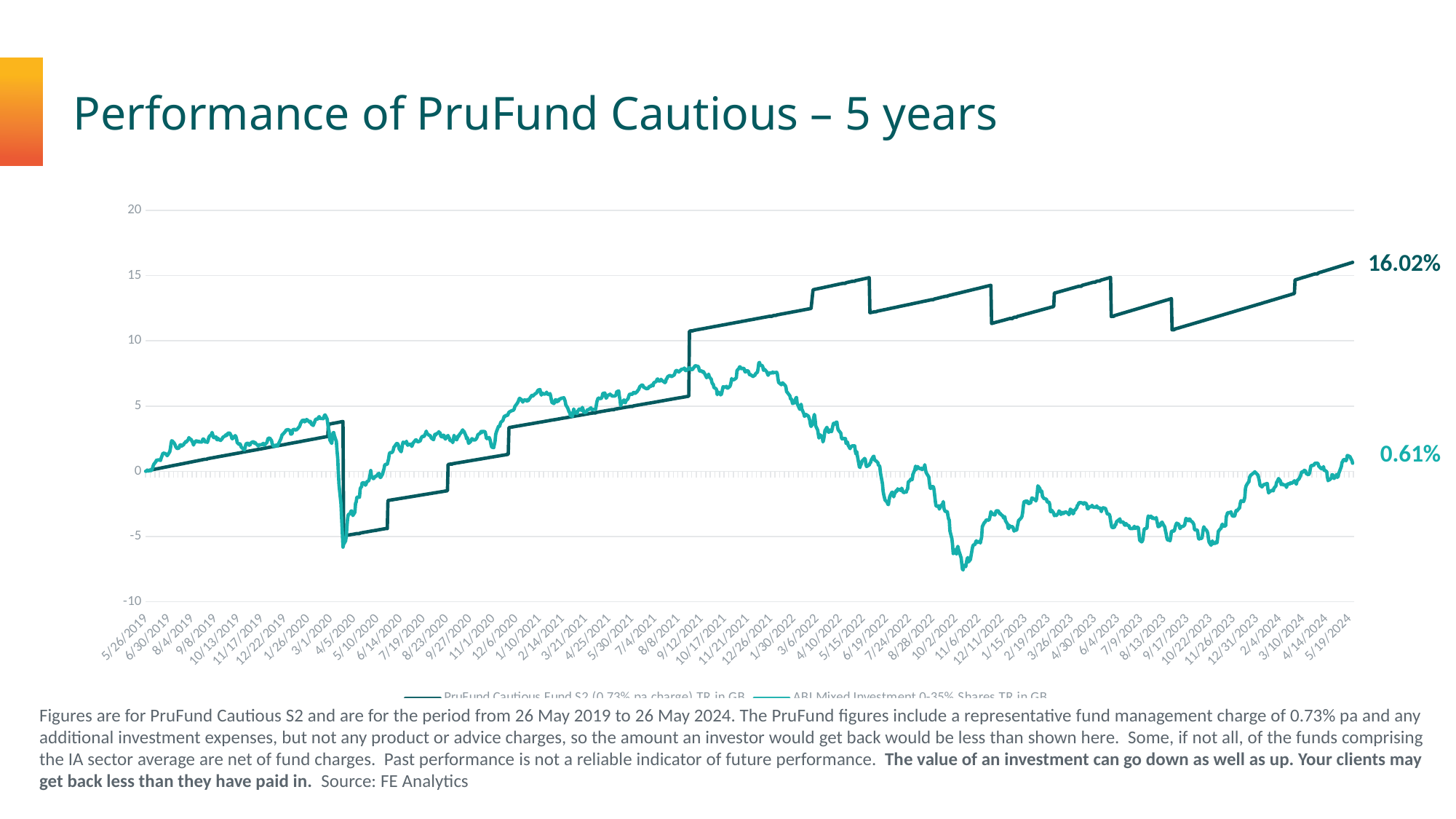
By how many percentage points does the PruFund Cautious Fund S2 end value exceed the ABI Mixed Investment 0-35% Shares end value? 15.41 How many series does the legend list? 2 What type of chart is shown on the slide? line chart What is the title of the chart slide? Performance of PruFund Cautious – 5 years Around 1/30/2022, is the value of the PruFund Cautious Fund S2 line greater or less than 10? greater What is the final value labelled for the PruFund Cautious Fund S2 line at the end of the period? 16.02% Is the lowest point of the ABI Mixed Investment 0-35% Shares line greater or less than -5? less What is the first date shown on the x axis? 5/26/2019 Which series ends the period with the higher value, PruFund Cautious Fund S2 or ABI Mixed Investment 0-35% Shares? PruFund Cautious Fund S2 What is the final value labelled for the ABI Mixed Investment 0-35% Shares line at the end of the period? 0.61% Over the full period, does the PruFund Cautious Fund S2 line rise or fall overall? rise Which series reaches the lowest point on the chart? ABI Mixed Investment 0-35% Shares